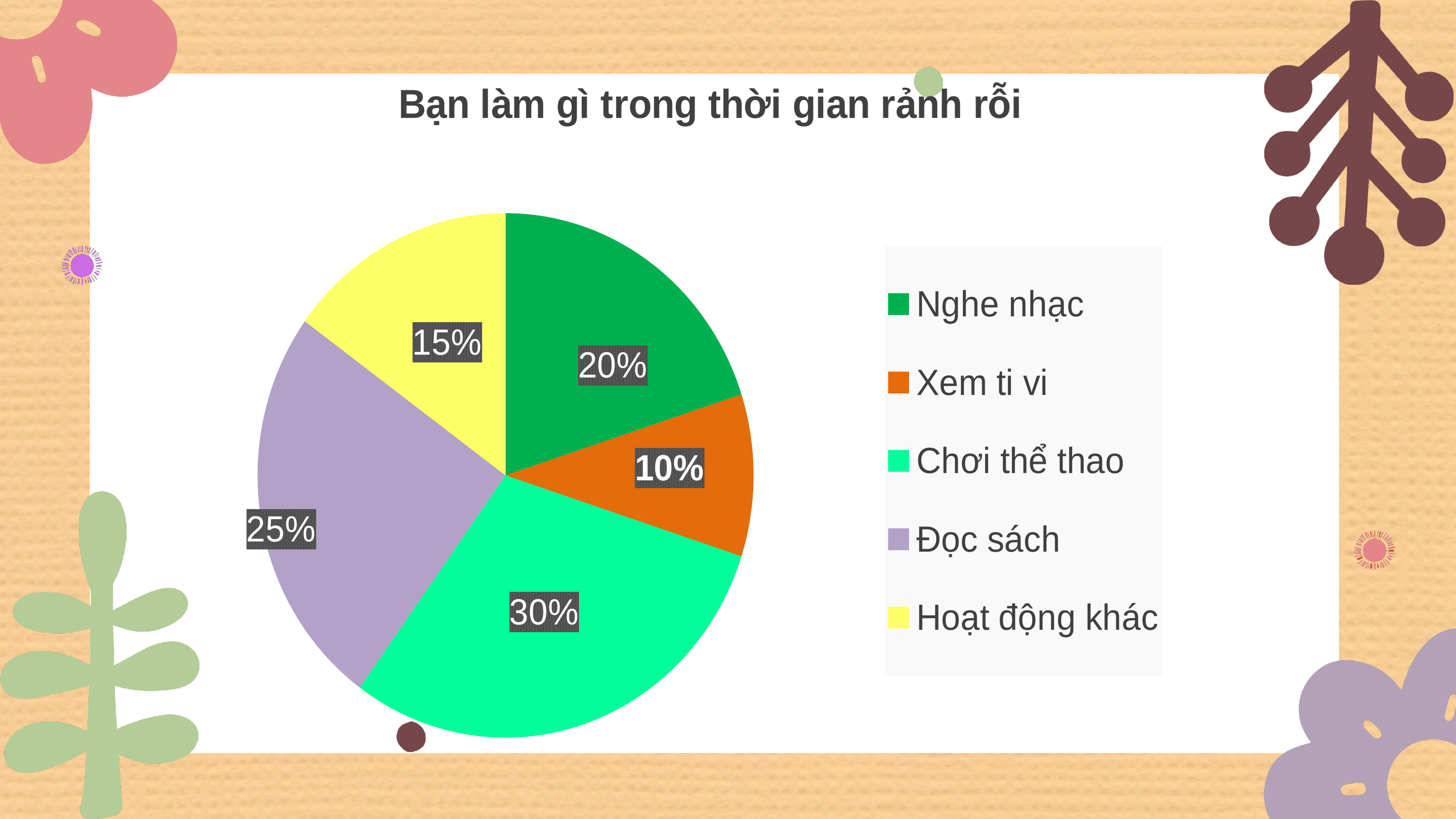
What percentage of the pie is 'Hoạt động khác'? 15% What percentage of the pie is 'Nghe nhạc'? 20% What percentage of the pie is 'Xem ti vi'? 10% Which is larger, the share for 'Đọc sách' or the share for 'Hoạt động khác'? Đọc sách How many categories does the pie chart have? 5 Which category has the smallest share of the pie? Xem ti vi Which category has the largest share of the pie? Chơi thể thao What is the difference between the shares of 'Chơi thể thao' and 'Nghe nhạc'? 10% What percentage of the pie is 'Đọc sách'? 25% What kind of chart is shown on the slide? Pie chart What percentage of the pie is 'Chơi thể thao'? 30% What is the title of the chart? Bạn làm gì trong thời gian rảnh rỗi